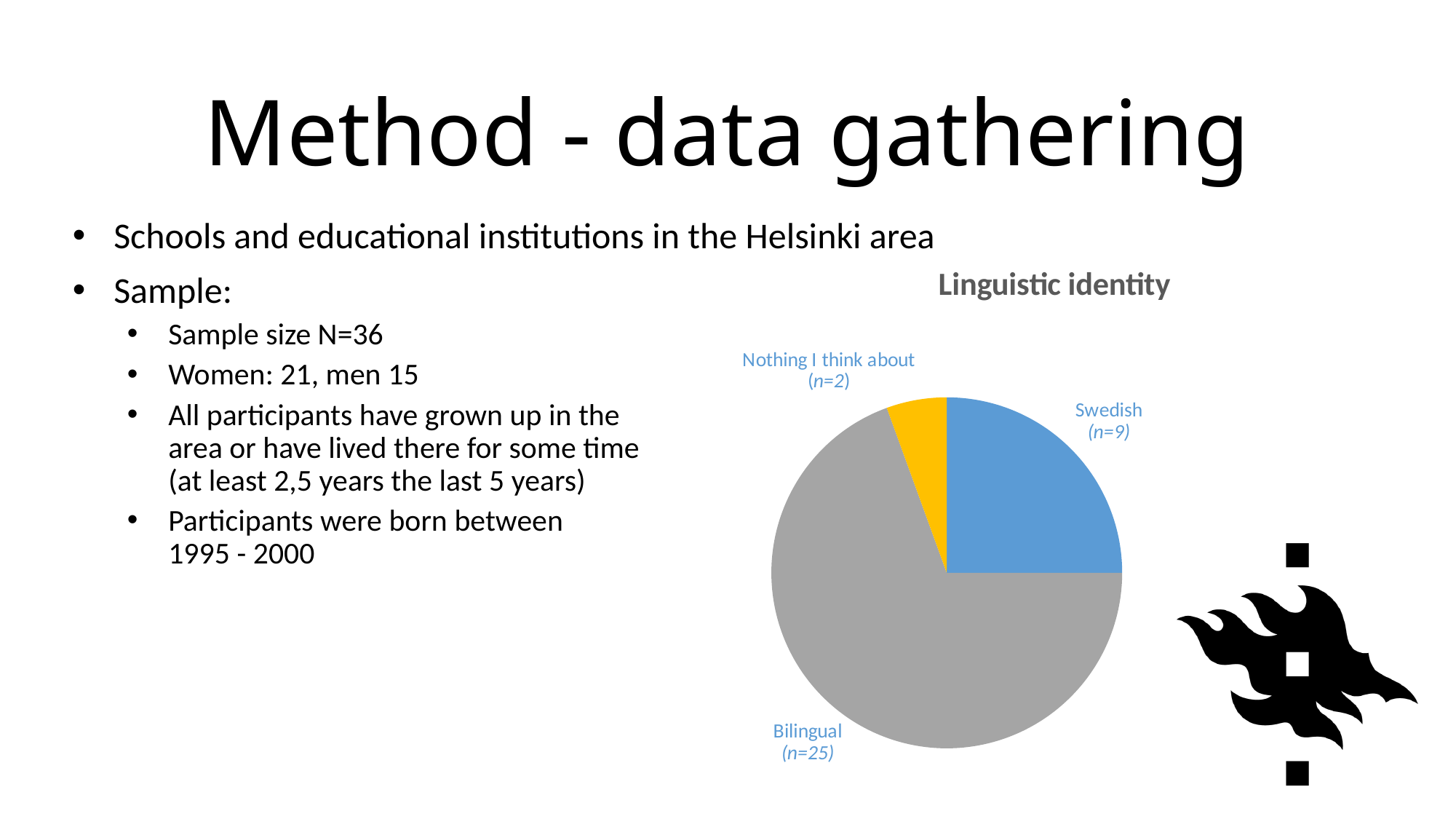
How many slices does the Linguistic identity pie chart have? 3 What is the n value for the Swedish slice? 9 Which category has the smallest slice in the pie chart? Nothing I think about What is the n value for the 'Nothing I think about' slice? 2 What share of the pie does the Swedish slice represent? 25% What type of chart is shown on the slide? pie chart How many more participants are Bilingual than Swedish? 16 Which is larger, the Swedish slice or the 'Nothing I think about' slice? Swedish What is the n value for the Bilingual slice? 25 Which category has the largest slice in the pie chart? Bilingual What is the difference in n between Swedish and 'Nothing I think about'? 7 What is the title of the chart? Linguistic identity